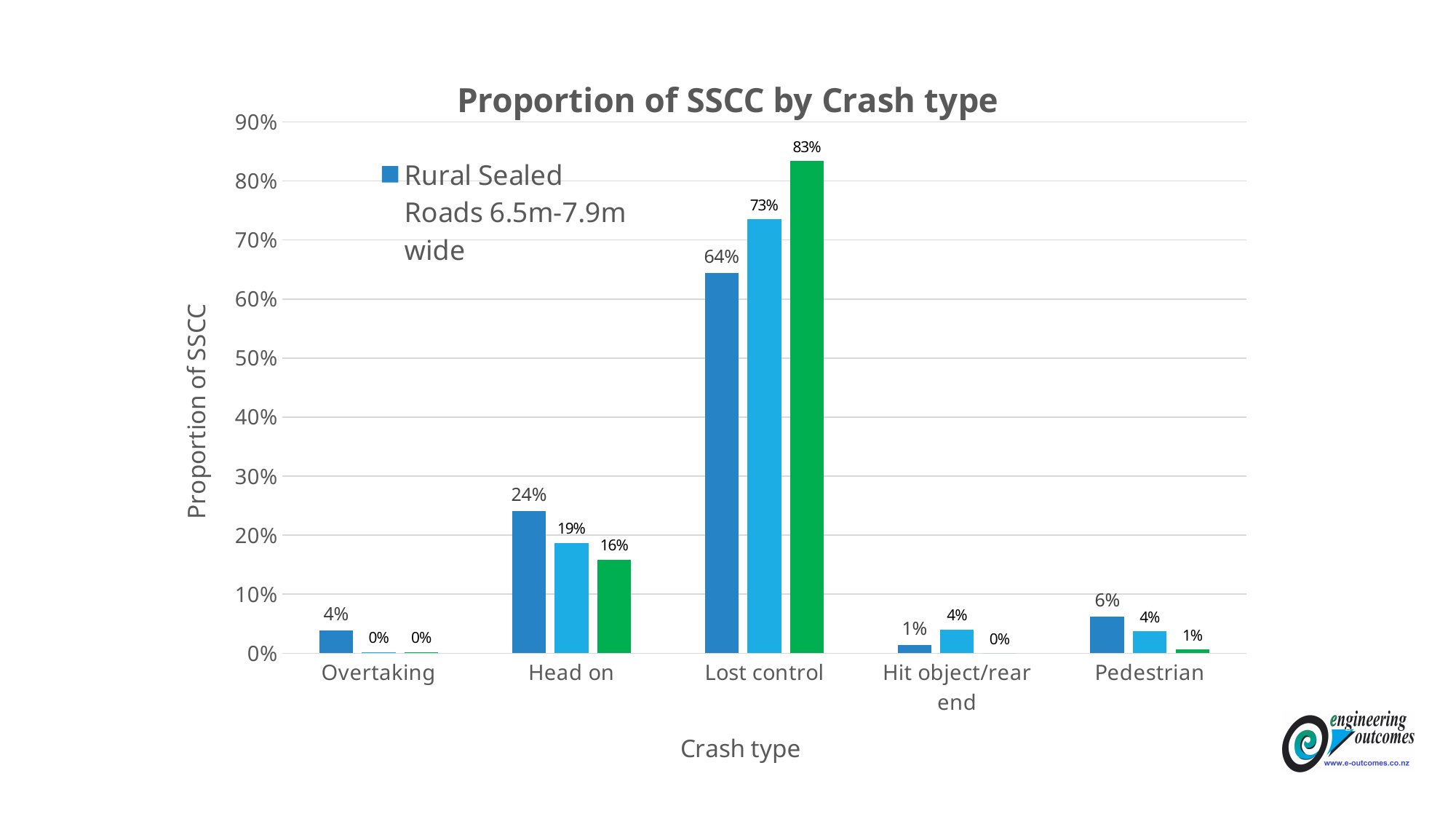
How many crash types are shown on the x axis? 5 What is the value for Lost control in the Rural Sealed Roads 6.5m-7.9m wide series? 64% Is the value for Lost control in the Rural Sealed Roads 6.5m-7.9m wide series greater or less than 50%? greater What kind of chart is shown on the slide? bar chart What is the value for Head on in the Rural Sealed Roads 6.5m-7.9m wide series? 24% What is the value for Pedestrian in the Rural Sealed Roads 6.5m-7.9m wide series? 6% Which crash type has the lowest value in the Rural Sealed Roads 6.5m-7.9m wide series? Hit object/rear end In the Rural Sealed Roads 6.5m-7.9m wide series, which is larger: Overtaking or Pedestrian? Pedestrian What is the title of the chart? Proportion of SSCC by Crash type In the Rural Sealed Roads 6.5m-7.9m wide series, how much higher is Lost control than Head on? 40% How many series does the legend list? 1 Which crash type has the highest value in the Rural Sealed Roads 6.5m-7.9m wide series? Lost control